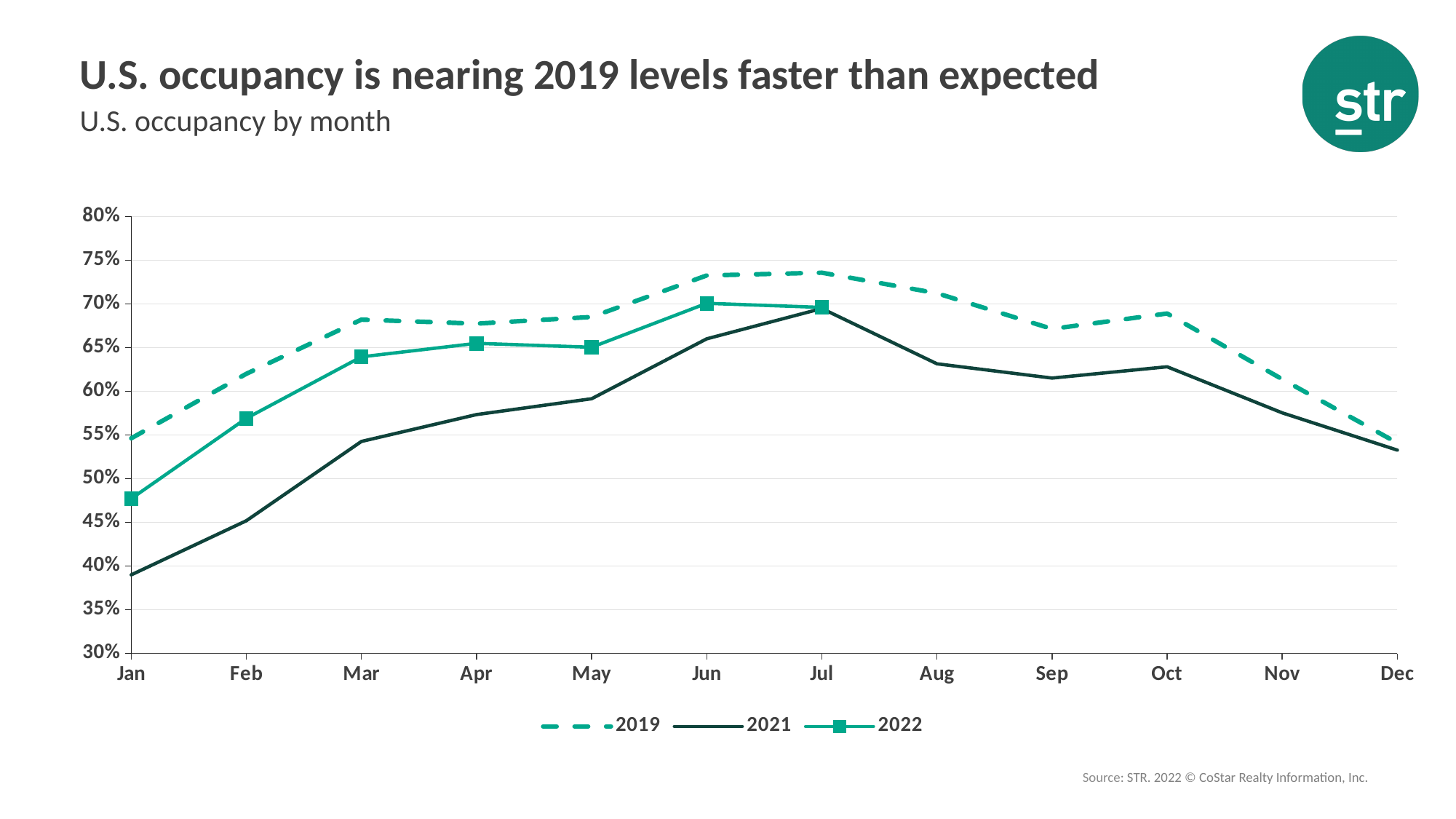
Does the 2021 series rise or fall from Jan to Jul? rise How many months are shown along the x axis? 12 In which month does the 2021 series reach its highest value? Jul How many data points are plotted for the 2022 series? 7 For Jun, which series has the higher value, 2021 or 2022? 2022 What kind of chart is shown on the slide? line chart Is the 2021 value for Jan greater or less than 40%? less Is the 2022 value for Jan greater or less than 50%? less How many series does the legend list? 3 Is the 2019 value for Jul greater or less than 70%? greater In which month is the 2022 series at its lowest value? Jan